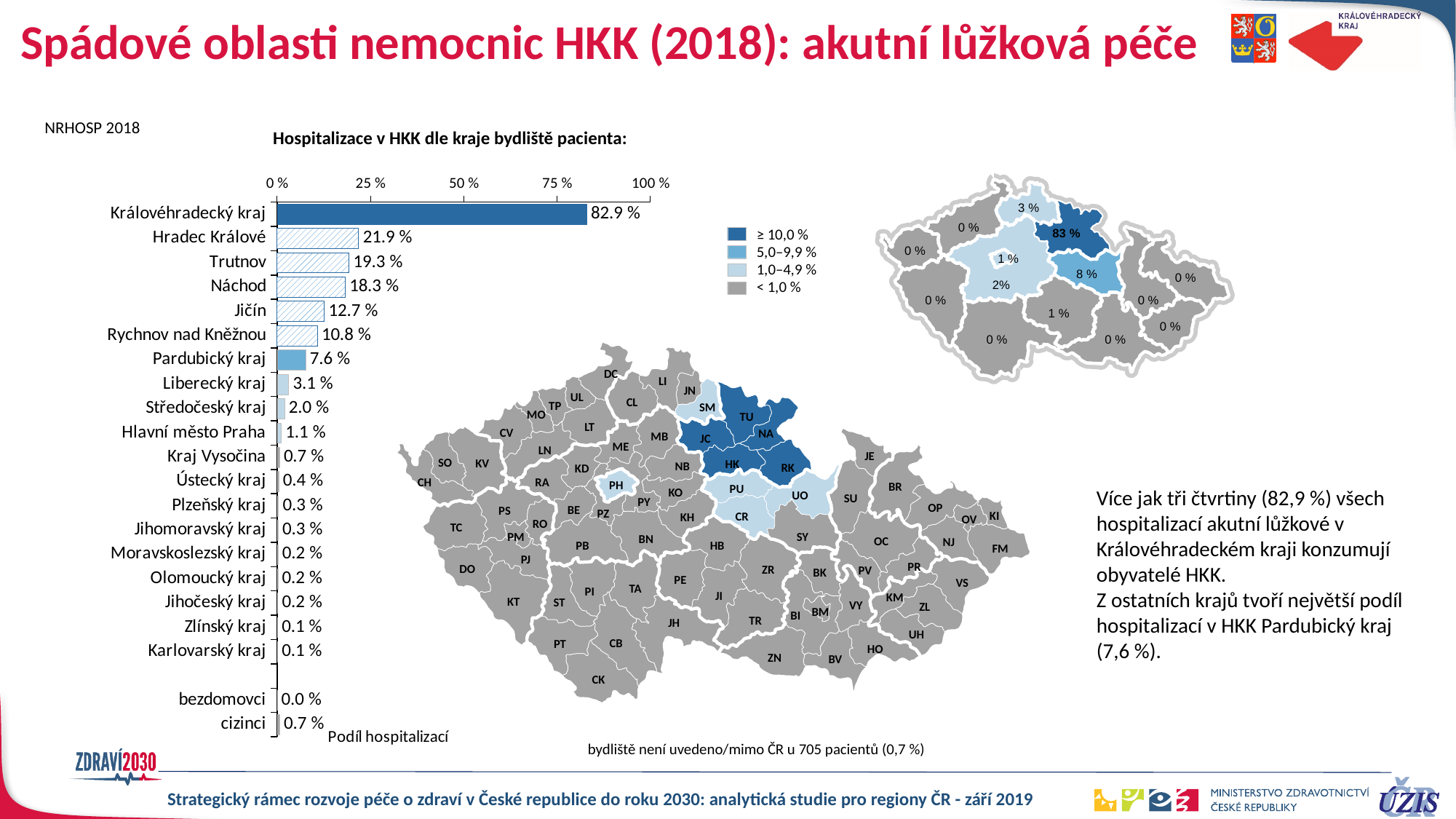
Which category has the highest value in the bar chart? Královéhradecký kraj What is the value for Trutnov in the bar chart? 19.3 % What is the value for Královéhradecký kraj in the bar chart? 82.9 % How many categories are shown in the bar chart? 21 Which category has the lowest value in the bar chart? bezdomovci Which is larger, the value for Náchod or the value for Jičín? Náchod What is the difference between the values for Hradec Králové and Trutnov? 2.6 % What is the difference between the values for Pardubický kraj and Liberecký kraj? 4.5 % Is the value for Královéhradecký kraj greater or less than 75 %? greater What is the value for Pardubický kraj in the bar chart? 7.6 % What kind of chart is shown on the left of the slide? bar chart What is the value for cizinci in the bar chart? 0.7 %